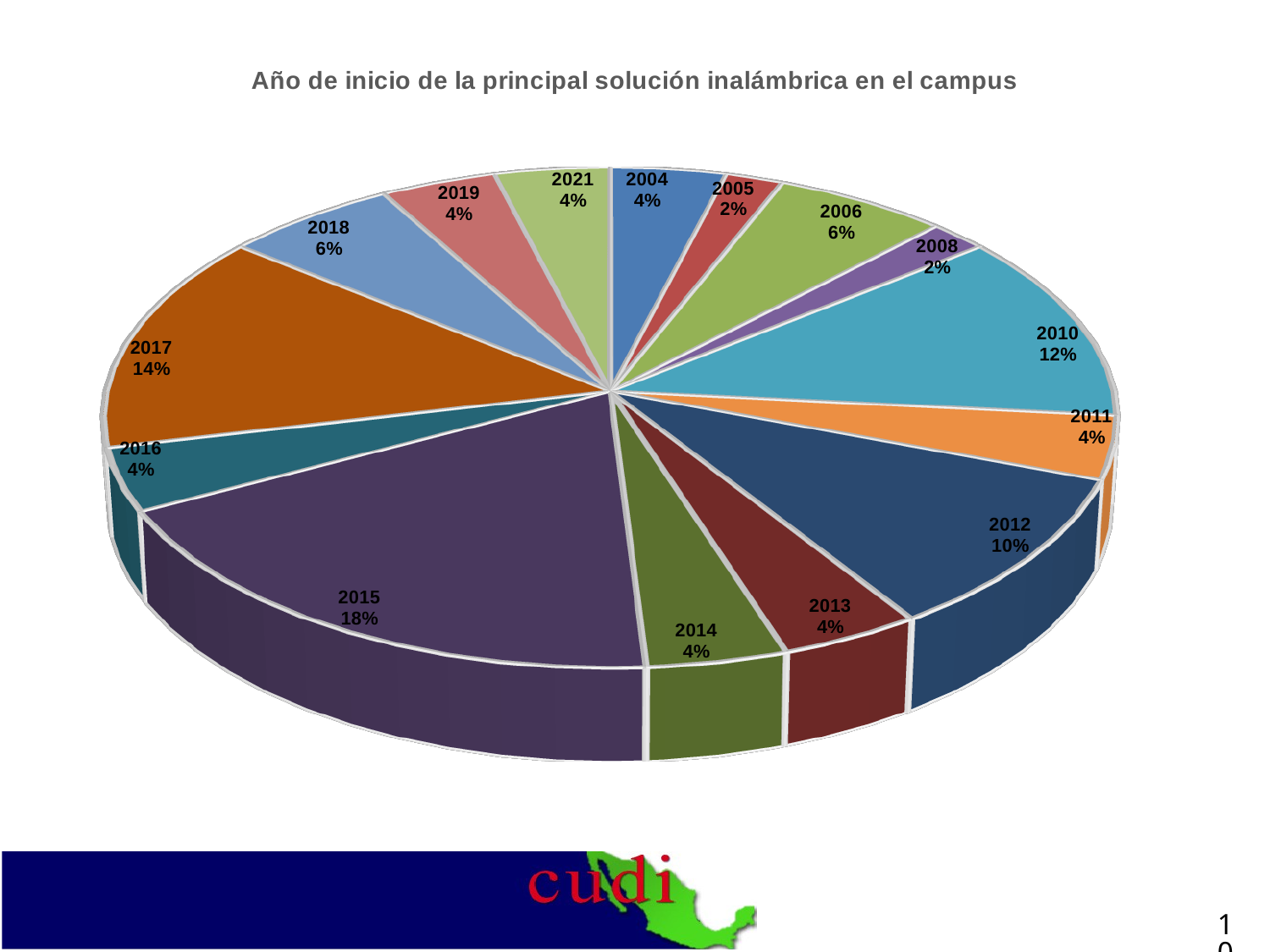
What percentage is shown for 2012? 10% How many slices does the pie chart have? 15 What is the title of the chart? Año de inicio de la principal solución inalámbrica en el campus What is the difference in percentage points between 2015 and 2017? 4 Which year has the largest slice of the pie? 2015 What share of the pie does 2015 represent? 18% What is the difference in percentage points between 2006 and 2005? 4 What percentage is shown for 2010? 12% Which is larger, the slice for 2010 or the slice for 2012? 2010 What type of chart is shown on the slide? pie chart What percentage is shown for 2017? 14% Which is larger, the slice for 2018 or the slice for 2019? 2018